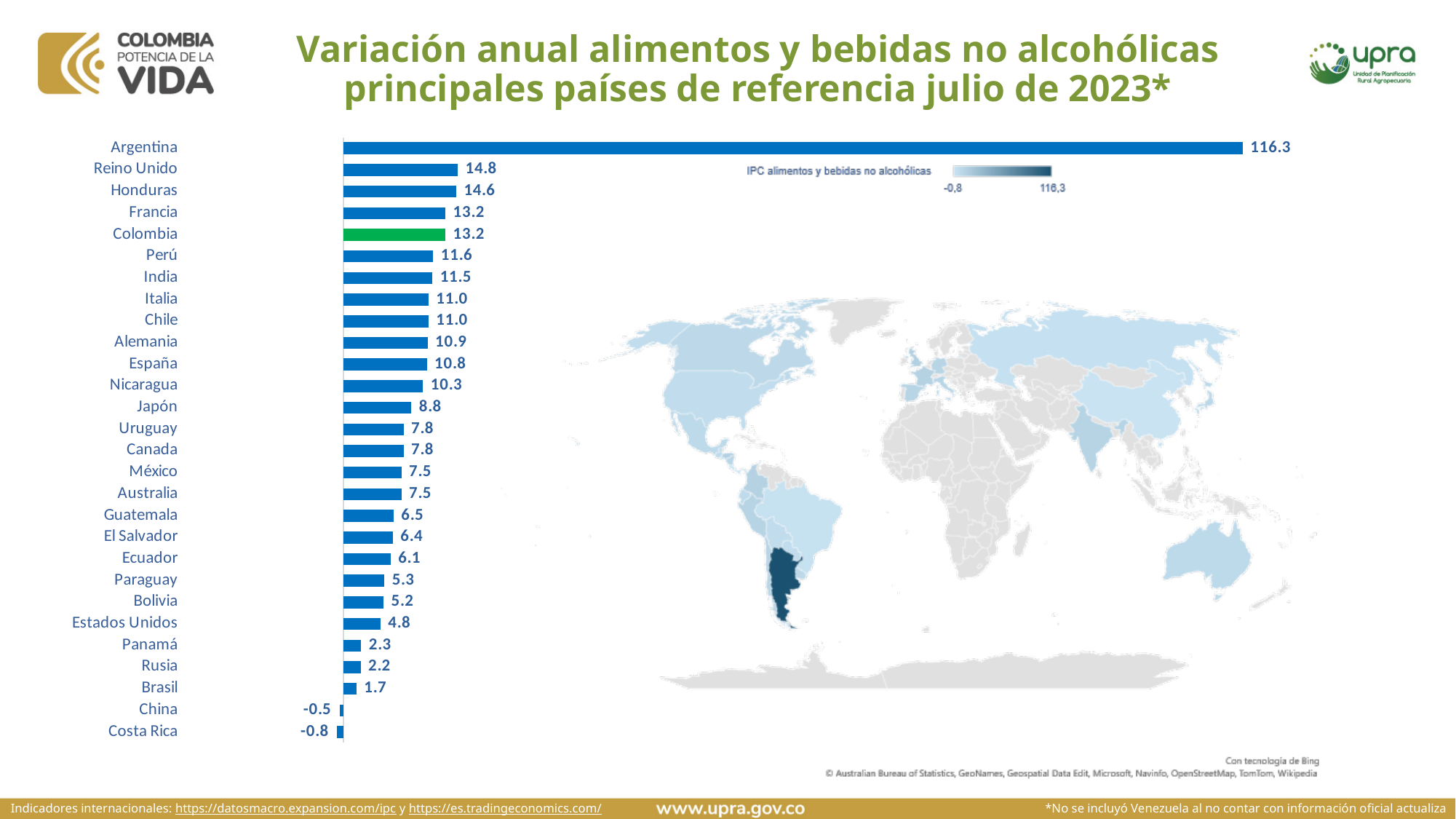
What is the value for Colombia in the bar chart? 13.2 What is the difference between the values for Reino Unido and Honduras in the bar chart? 0.2 Which country has the lowest value in the bar chart? Costa Rica Which has a larger value in the bar chart, Brasil or Rusia? Rusia What is the value for Argentina in the bar chart? 116.3 How many countries are shown in the bar chart? 28 Which country's bar is coloured green in the bar chart? Colombia What is the value for Estados Unidos in the bar chart? 4.8 Which has a larger value in the bar chart, Perú or Japón? Perú What is the difference between the values for Argentina and Reino Unido in the bar chart? 101.5 What kind of chart is used to show the values by country on the left of the slide? Bar chart Which country has the highest value in the bar chart? Argentina